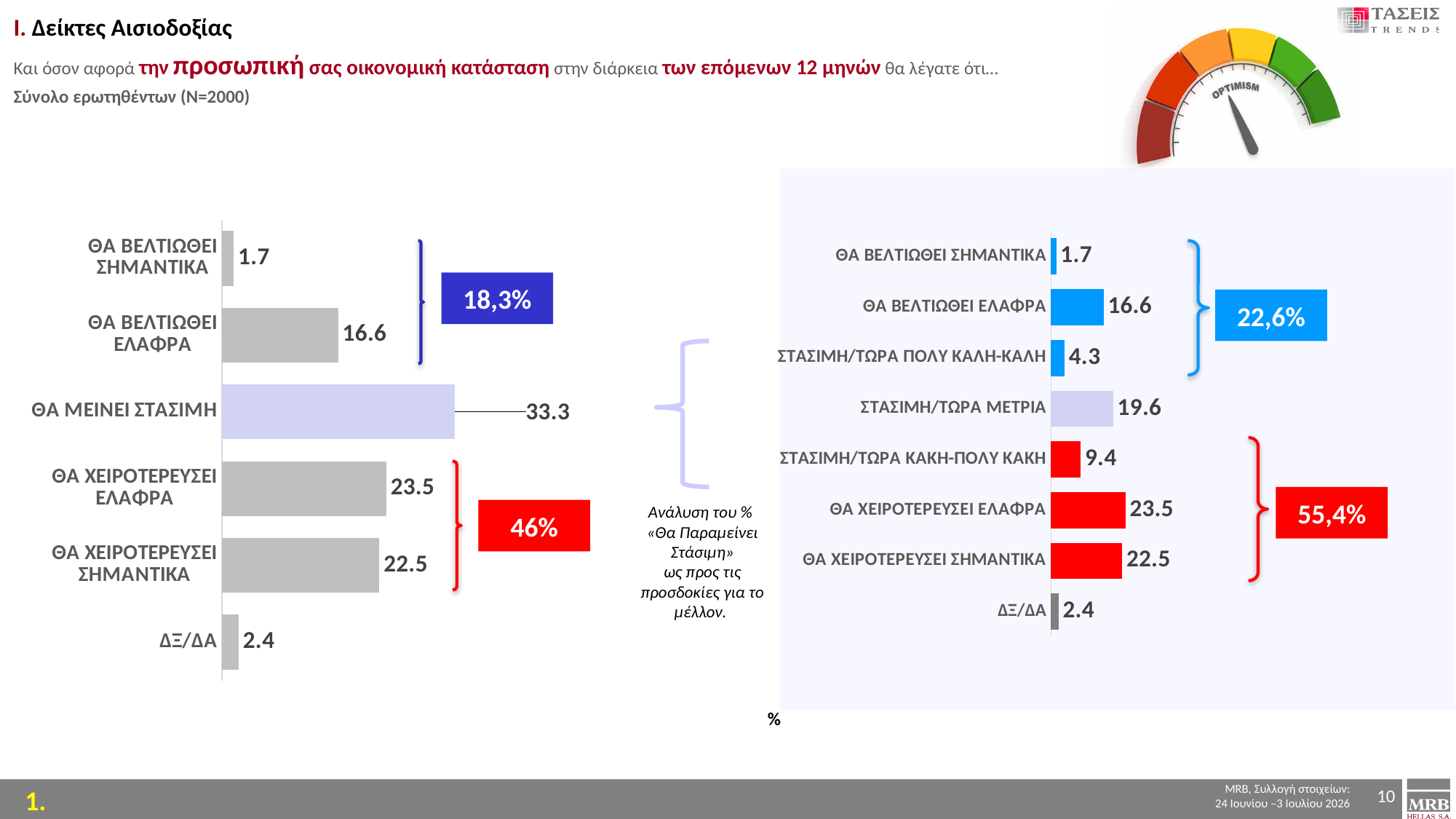
In the left chart, what is the value for ΘΑ ΧΕΙΡΟΤΕΡΕΥΣΕΙ ΕΛΑΦΡΑ? 23.5 In the left chart, how many categories are shown? 6 In the left chart, which category has the highest value? ΘΑ ΜΕΙΝΕΙ ΣΤΑΣΙΜΗ In the left chart, what is the difference between ΘΑ ΜΕΙΝΕΙ ΣΤΑΣΙΜΗ and ΘΑ ΒΕΛΤΙΩΘΕΙ ΕΛΑΦΡΑ? 16.7 In the left chart, which category has the lowest value? ΘΑ ΒΕΛΤΙΩΘΕΙ ΣΗΜΑΝΤΙΚΑ What type of chart is the right chart? Bar chart In the left chart, what is the value for ΘΑ ΜΕΙΝΕΙ ΣΤΑΣΙΜΗ? 33.3 In the left chart, what combined percentage is shown in the red box for the two ΘΑ ΧΕΙΡΟΤΕΡΕΥΣΕΙ categories? 46% In the right chart, what is the value for ΣΤΑΣΙΜΗ/ΤΩΡΑ ΚΑΚΗ-ΠΟΛΥ ΚΑΚΗ? 9.4 In the right chart, what is the value for ΣΤΑΣΙΜΗ/ΤΩΡΑ ΜΕΤΡΙΑ? 19.6 In the right chart, how many categories are shown? 8 In the right chart, which is larger: ΣΤΑΣΙΜΗ/ΤΩΡΑ ΠΟΛΥ ΚΑΛΗ-ΚΑΛΗ or ΣΤΑΣΙΜΗ/ΤΩΡΑ ΚΑΚΗ-ΠΟΛΥ ΚΑΚΗ? ΣΤΑΣΙΜΗ/ΤΩΡΑ ΚΑΚΗ-ΠΟΛΥ ΚΑΚΗ